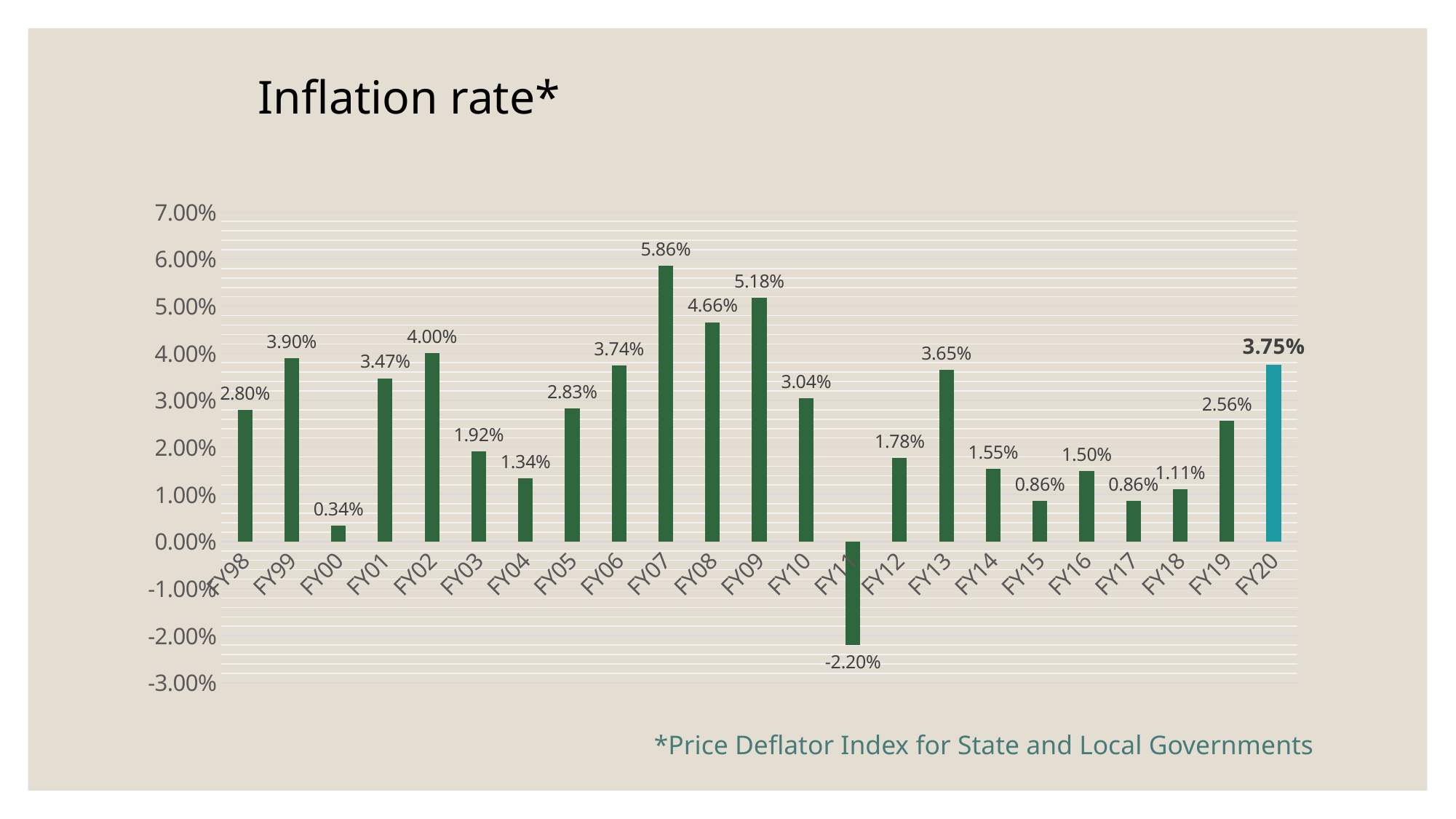
Is the value for FY10 greater or less than 3.00%? greater What kind of chart is shown on the slide? Bar chart Which bar is shown in a different colour from the others? FY20 Which fiscal year has the highest inflation rate? FY07 Which fiscal year has the lowest inflation rate? FY11 What is the inflation rate for FY07? 5.86% What is the inflation rate for FY11? -2.20% What is the inflation rate for FY20? 3.75% Do the values rise or fall from FY13 to FY15? Fall How many fiscal years are shown on the x axis? 23 Which is larger, the inflation rate for FY02 or FY13? FY02 What is the difference between the inflation rates for FY09 and FY08? 0.52%